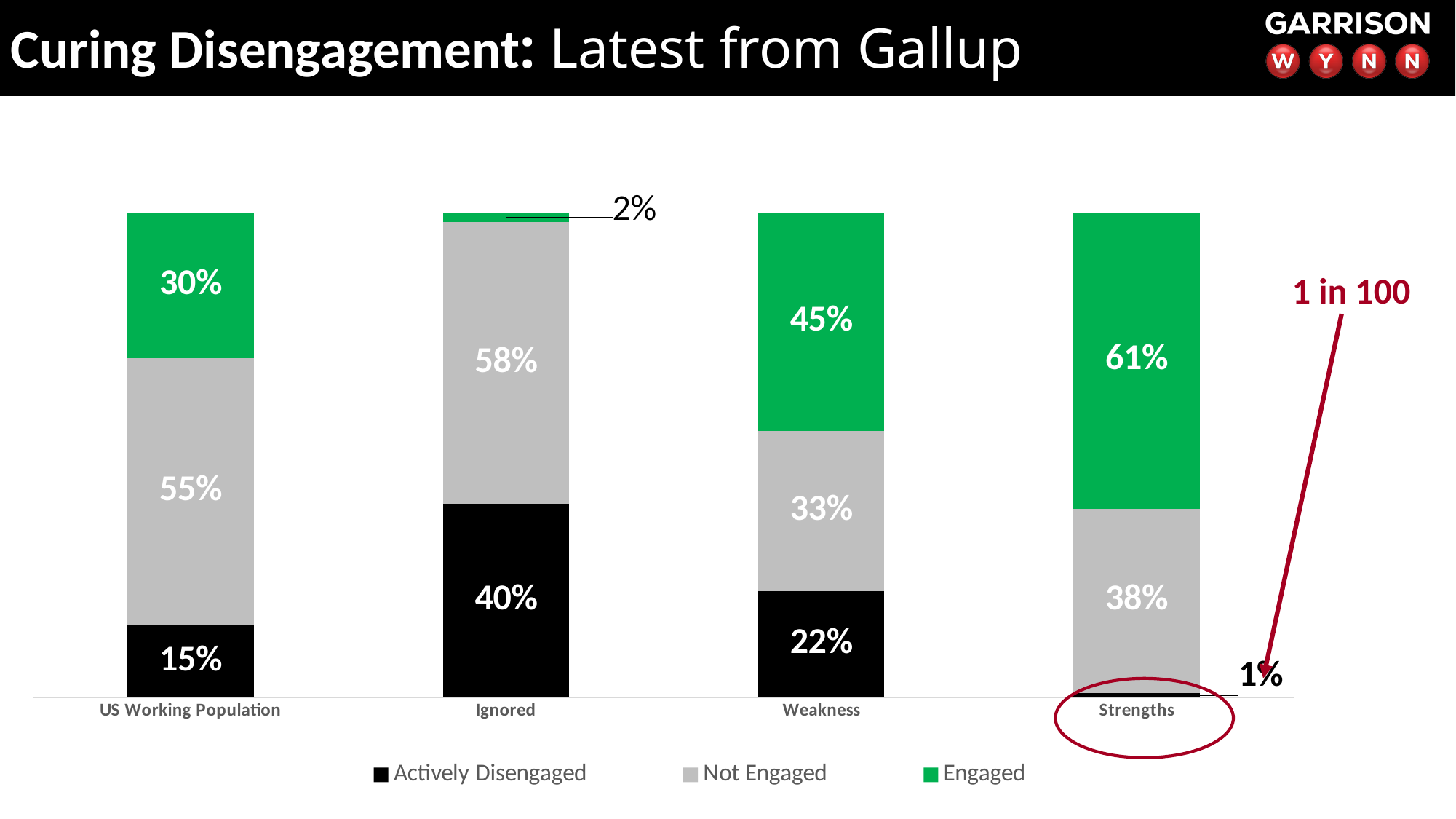
What is the difference between the Engaged values for Strengths and Weakness? 16% Which category has the lowest Actively Disengaged value? Strengths How many series does the legend list? 3 What kind of chart is shown on the slide? Stacked bar chart How many categories are shown along the x axis? 4 Which series is shown in green in the legend? Engaged Which is larger, the Not Engaged value for Ignored or the Not Engaged value for Weakness? Ignored What is the Engaged value for Ignored? 2% What is the Engaged value for Strengths? 61% What is the Not Engaged value for US Working Population? 55% Which category has the highest Engaged value? Strengths What is the Actively Disengaged value for Ignored? 40%